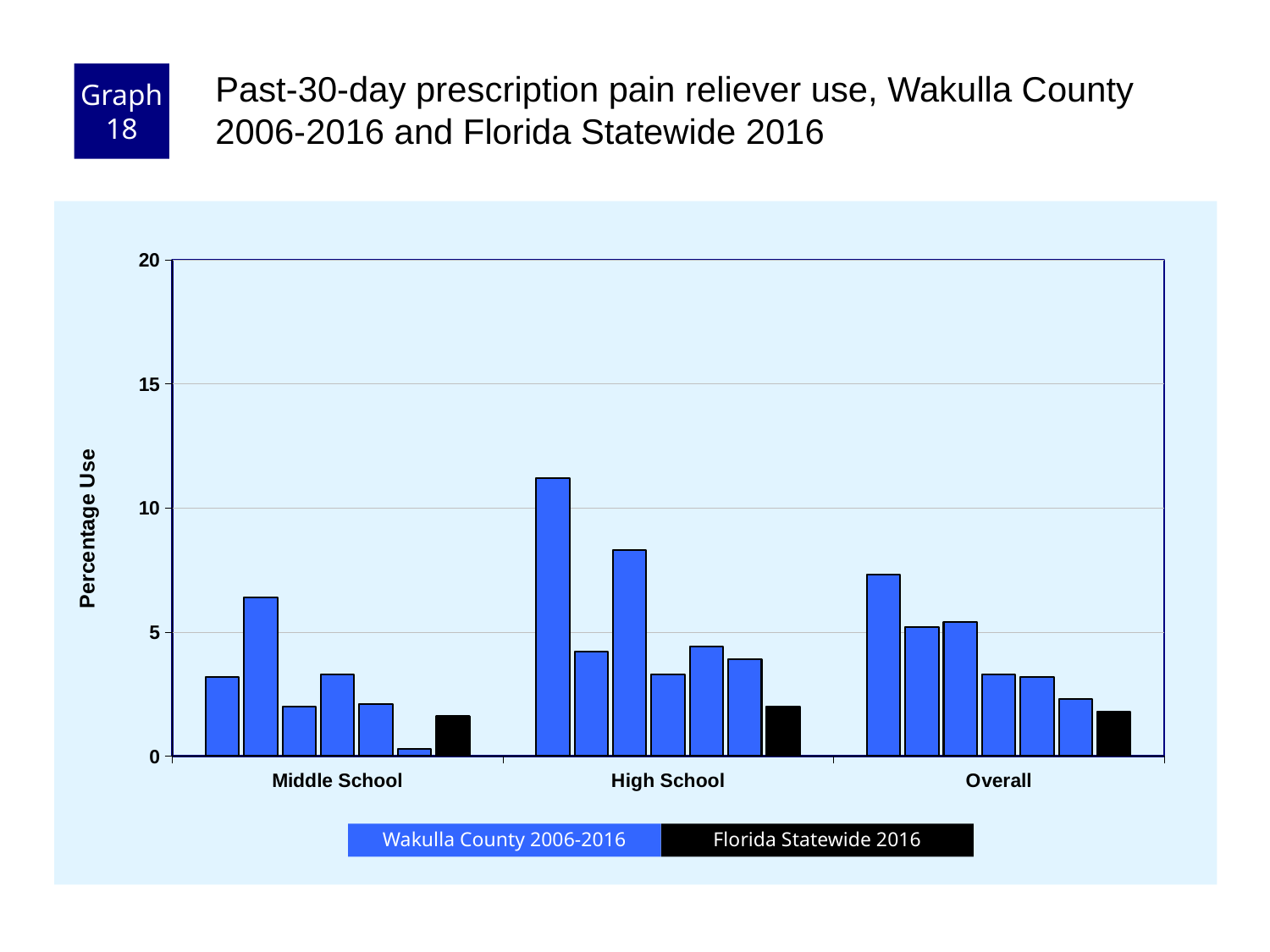
In the Overall group, is the Florida Statewide 2016 bar higher or lower than the first Wakulla County bar? lower Which category group contains the tallest bar on the chart? High School Is the Florida Statewide 2016 value for Middle School greater or less than 5? less Which category group contains the shortest bar on the chart? Middle School What are the two series named in the legend? Wakulla County 2006-2016 and Florida Statewide 2016 Is the tallest Wakulla County bar in the High School group greater or less than 10? greater What is the label on the y axis? Percentage Use What kind of chart is shown on the slide? bar chart How many category groups are shown along the x axis? 3 Is the Florida Statewide 2016 value for High School greater or less than 5? less How many series does the legend list? 2 Across the Wakulla County bars in the Overall group, do the values generally rise or fall from left to right? fall